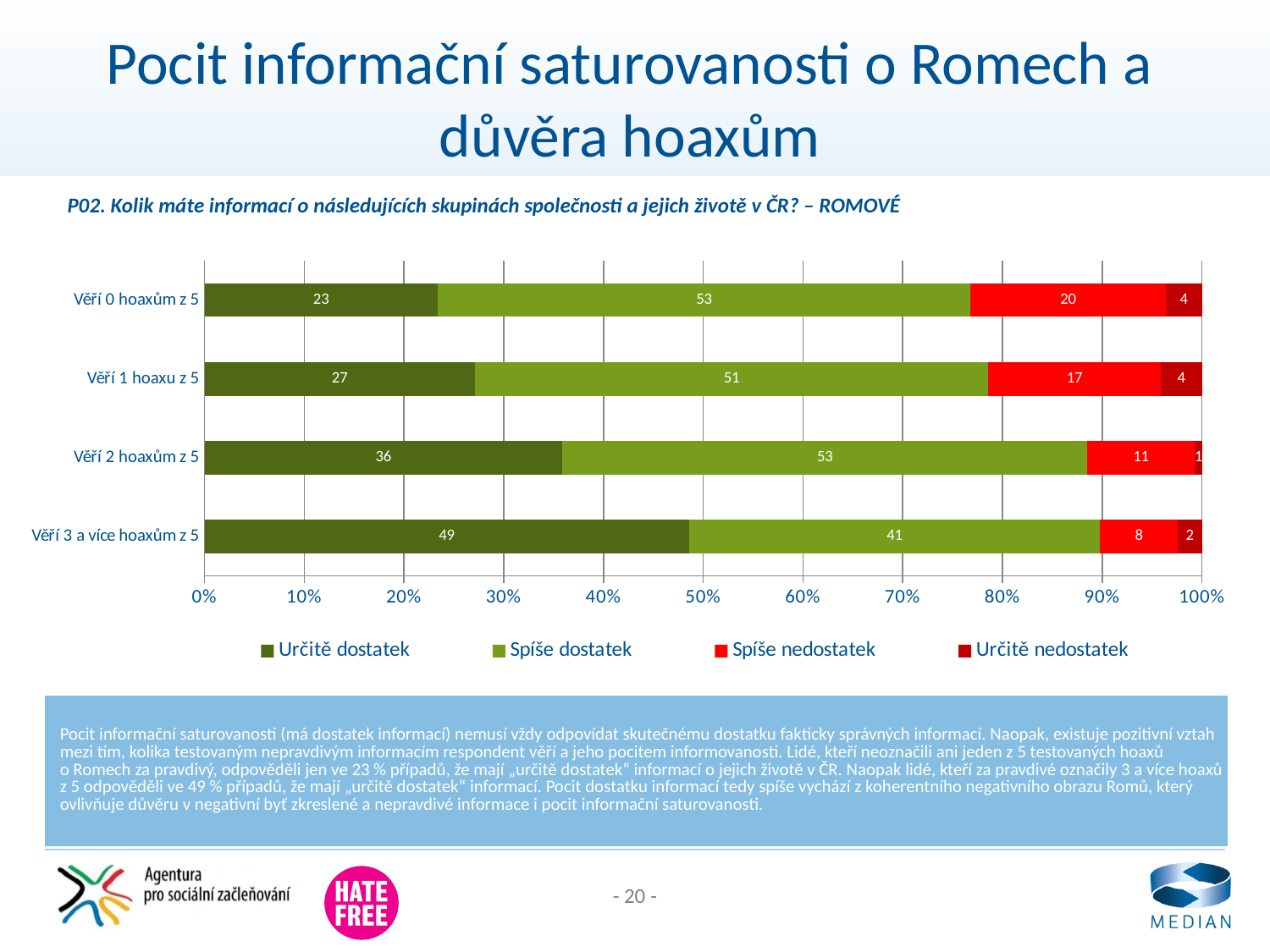
Which category has the highest value for "Určitě dostatek"? Věří 3 a více hoaxům z 5 What is the difference between the "Určitě dostatek" values for "Věří 3 a více hoaxům z 5" and "Věří 0 hoaxům z 5"? 26 Which category has the lowest value for "Spíše nedostatek"? Věří 3 a více hoaxům z 5 What is the value of "Spíše dostatek" for "Věří 1 hoaxu z 5"? 51 What is the value of "Určitě nedostatek" for "Věří 3 a více hoaxům z 5"? 2 What is the value of "Určitě dostatek" for "Věří 0 hoaxům z 5"? 23 Which legend entry is shown in dark red? Určitě nedostatek What is the value of "Spíše nedostatek" for "Věří 2 hoaxům z 5"? 11 What type of chart is shown on the slide? Stacked bar chart How many categories are plotted on the chart? 4 How many series does the legend list? 4 Which is larger: the "Spíše dostatek" value for "Věří 0 hoaxům z 5" or for "Věří 3 a více hoaxům z 5"? Věří 0 hoaxům z 5